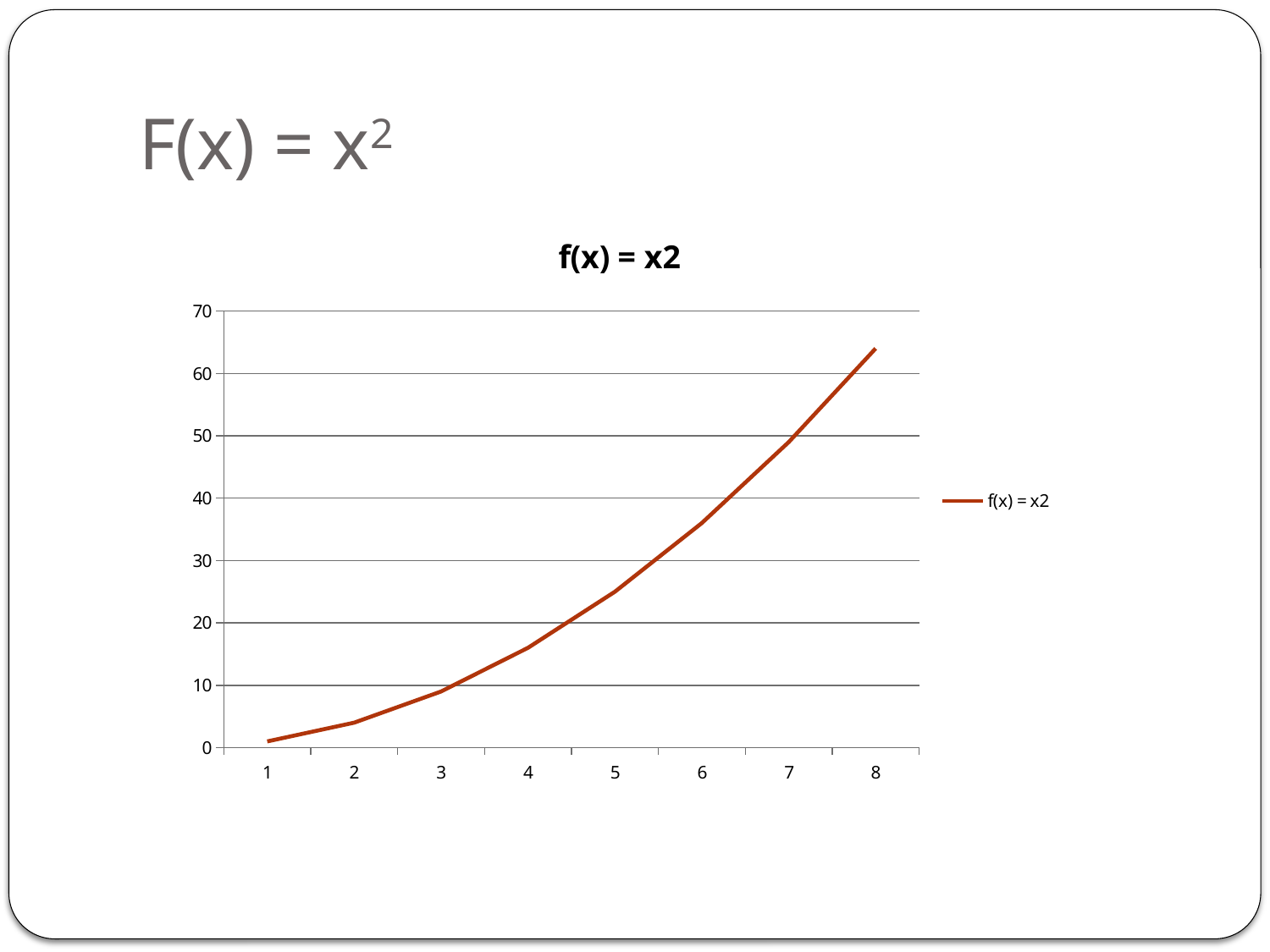
What kind of chart is shown on the slide? Line chart What is the title of the chart? f(x) = x2 At which x value is the plotted value highest? 8 Is the value at x = 8 greater or less than 60? greater How many series does the legend list? 1 Which is larger, the value at x = 3 or the value at x = 7? x = 7 Do the values rise or fall as x increases from 1 to 8? Rise Is the value at x = 2 greater or less than 10? less How many x-axis categories are plotted on the chart? 8 Is the value at x = 6 greater or less than 30? greater At which x value is the plotted value lowest? 1